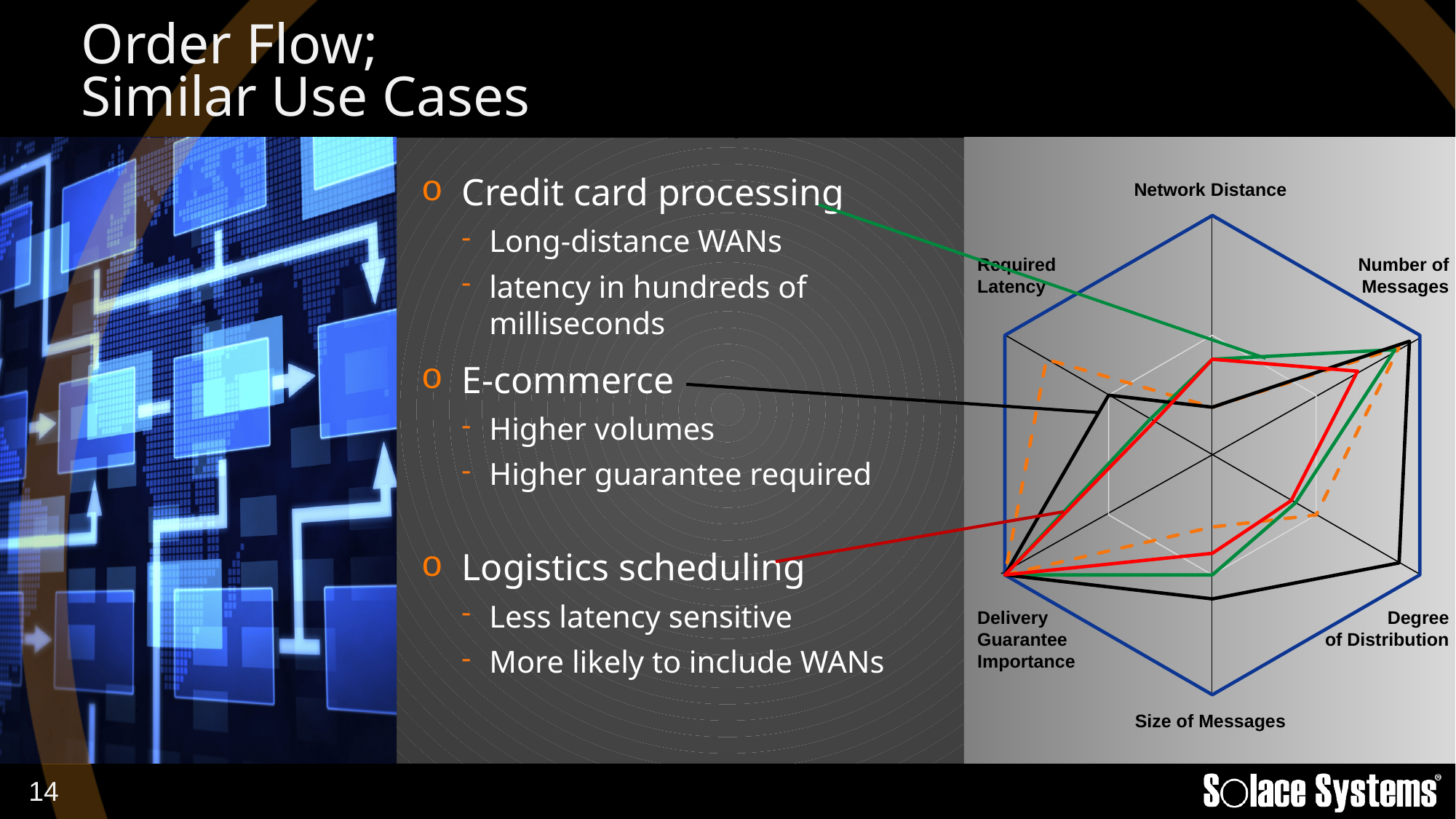
On the Required Latency axis, which extends further: the black (E-commerce) line or the red (Logistics scheduling) line? Black (E-commerce) How many lines (series) are plotted on the radar chart, including the dashed one? 5 Which use case does the black line on the radar chart represent? E-commerce On the Degree of Distribution axis, which extends further: the black (E-commerce) line or the red (Logistics scheduling) line? Black (E-commerce) On the Network Distance axis, which extends further: the red (Logistics scheduling) line or the black (E-commerce) line? Red (Logistics scheduling) How many axes (categories) does the radar chart have? 6 Which use case does the green line on the radar chart represent? Credit card processing What kind of chart is shown on the right side of the slide? Radar chart